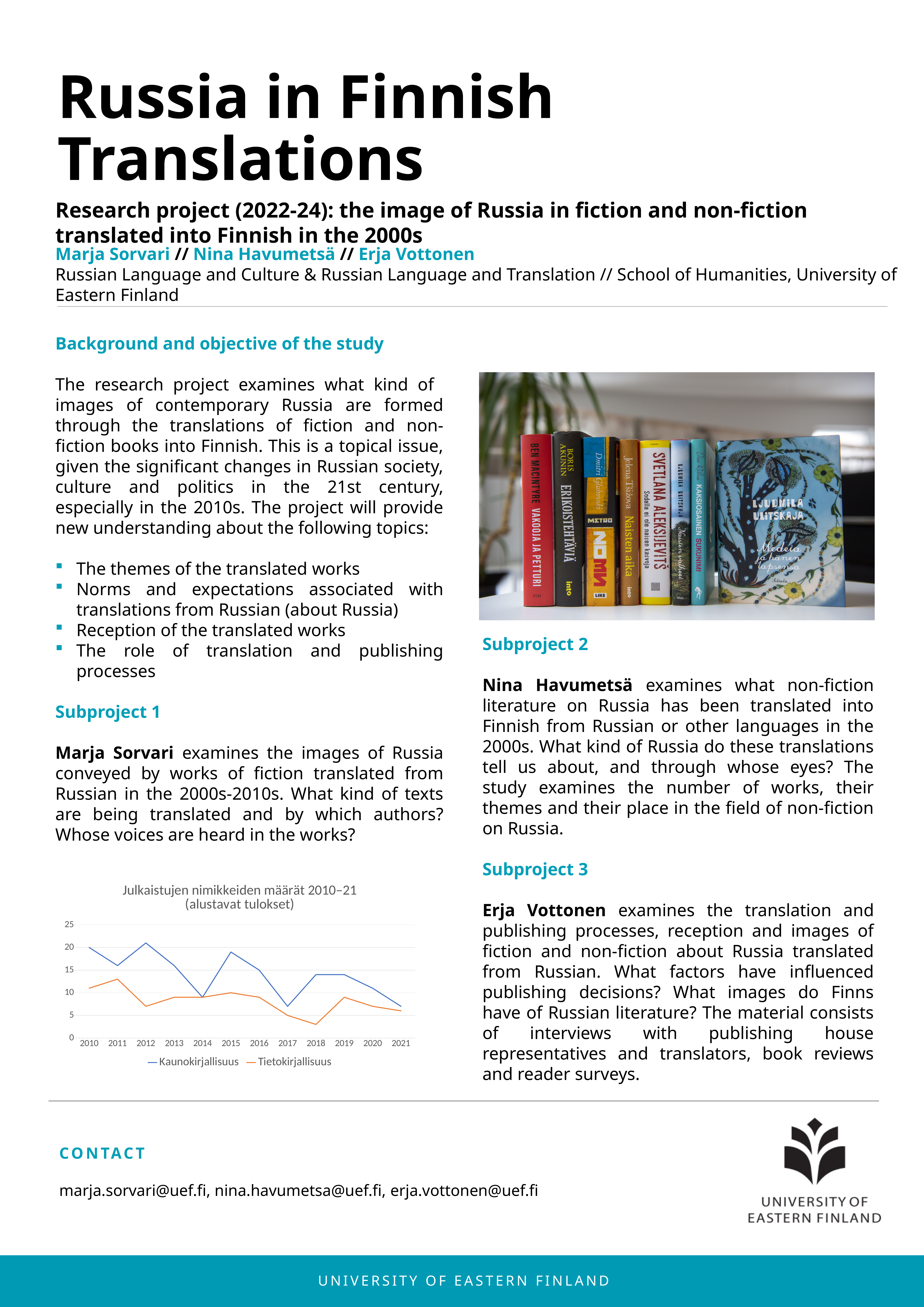
How many series does the chart's legend list? 2 Does the Kaunokirjallisuus series rise or fall from 2019 to 2021? fall Which series is drawn in orange in the chart? Tietokirjallisuus How many years are plotted along the x axis of the chart? 12 In 2012, which series has the larger value, Kaunokirjallisuus or Tietokirjallisuus? Kaunokirjallisuus In which year does the Tietokirjallisuus series reach its lowest value? 2018 What kind of chart is shown on the slide? line chart Is the Kaunokirjallisuus value for 2010 greater or less than 15? greater In which year does the Kaunokirjallisuus series reach its highest value? 2012 What is the title of the chart? Julkaistujen nimikkeiden määrät 2010–21 (alustavat tulokset) Is the Kaunokirjallisuus value for 2015 greater or less than 15? greater Is the Tietokirjallisuus value for 2018 greater or less than 5? less